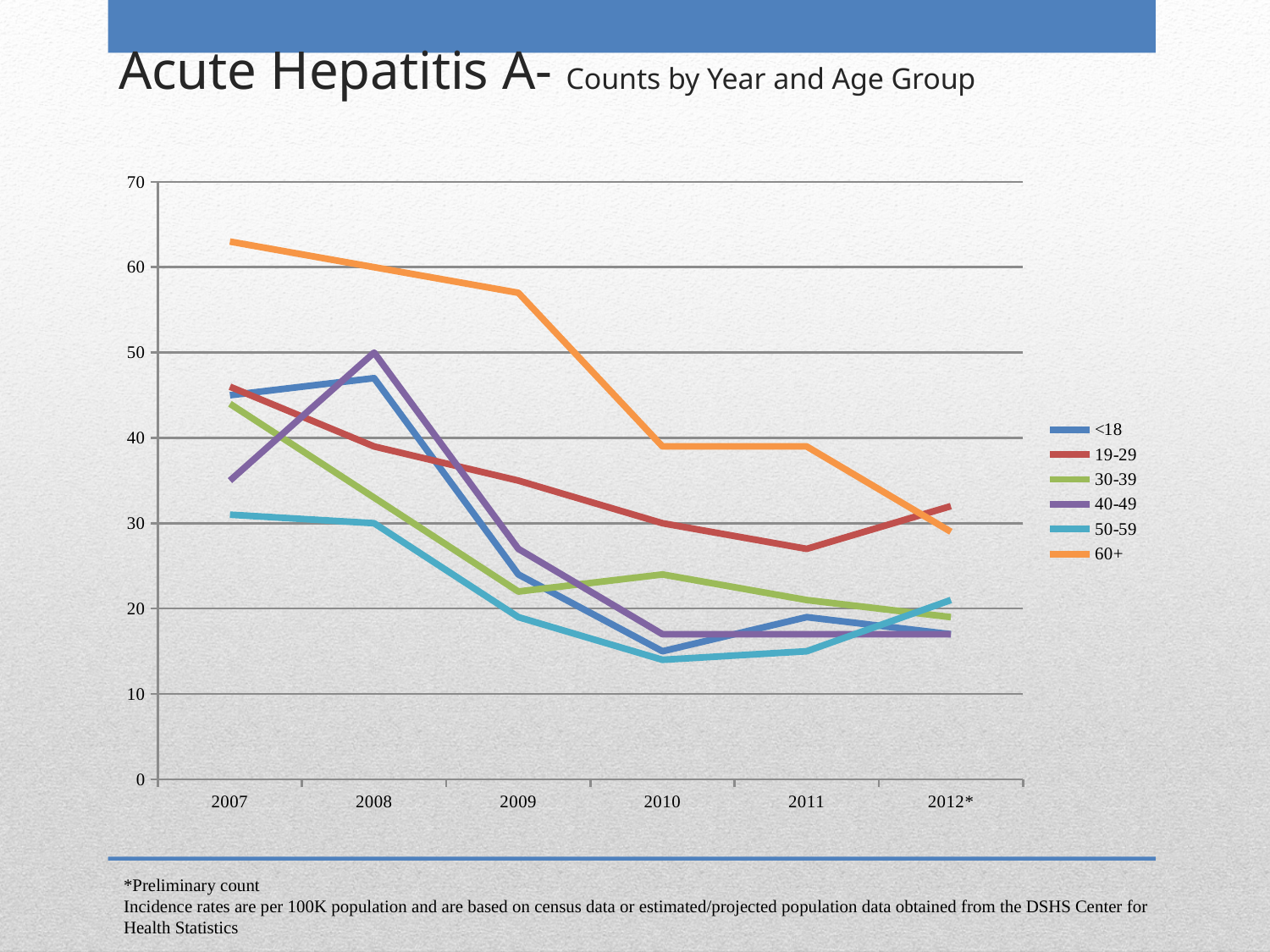
In 2009, which has the larger count: the 60+ age group or the 19-29 age group? 60+ Is the value for the <18 age group in 2010 greater or less than 20? less How many age-group series does the legend list? 6 Does the count for the 60+ age group rise or fall from 2007 to 2012*? fall What kind of chart is shown on the slide? line chart What is the title of the chart on the slide? Acute Hepatitis A- Counts by Year and Age Group Is the value for the 60+ age group in 2007 greater or less than 60? greater Which age group has the lowest count in 2007? 50-59 Is the value for the 40-49 age group in 2009 greater or less than 30? less How many years are shown along the x axis? 6 Which age group has the highest count in 2011? 60+ Which age group has the highest count in 2007? 60+